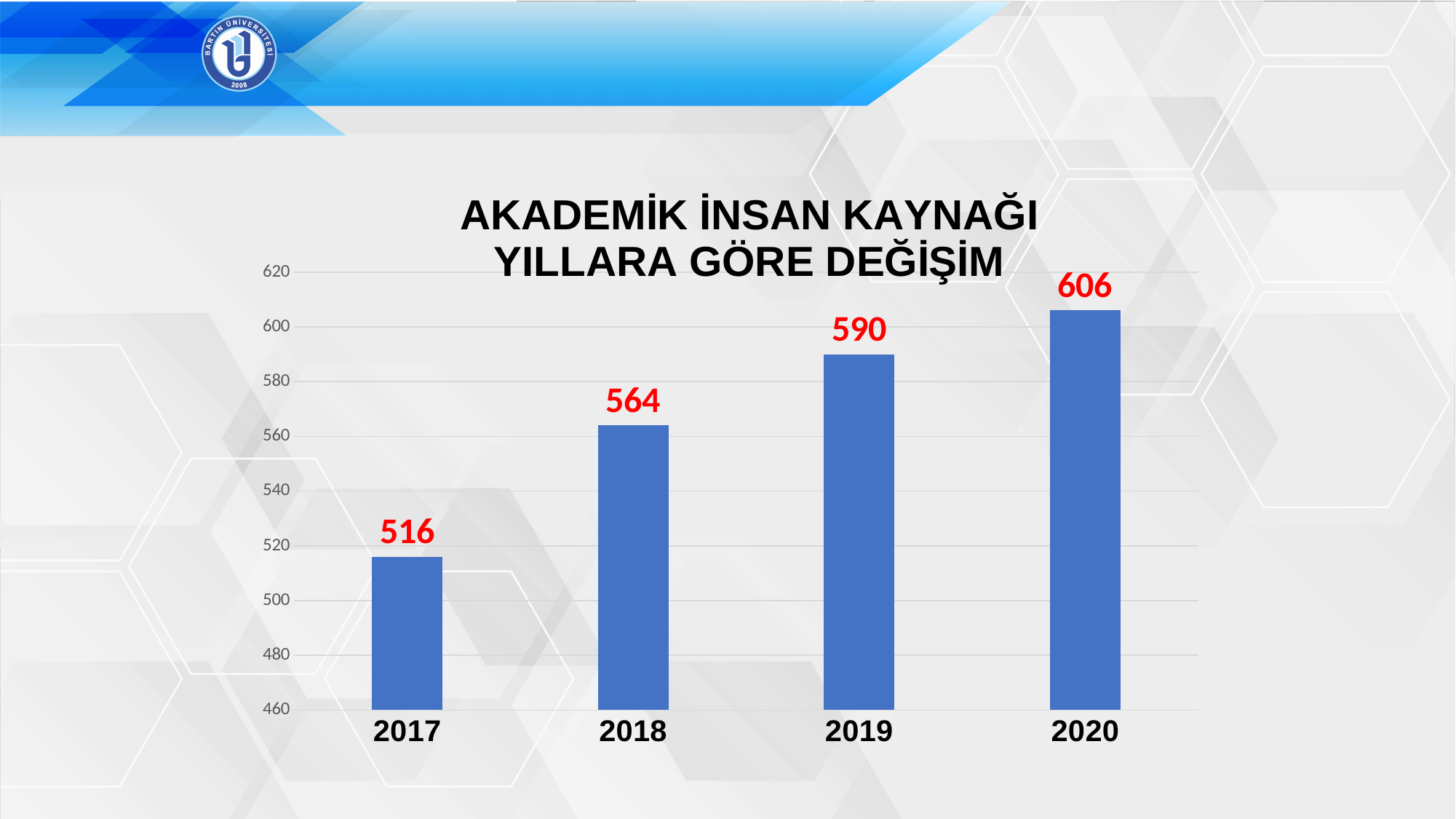
What is the difference between the values for 2019 and 2018? 26 What is the value for 2017? 516 What is the value for 2019? 590 What is the value for 2018? 564 What kind of chart is shown on the slide? bar chart Which is larger, the value for 2018 or the value for 2019? 2019 What is the difference between the values for 2020 and 2017? 90 Which year has the lowest value? 2017 What is the value for 2020? 606 Do the values rise or fall from 2017 to 2020? rise How many years are shown on the chart? 4 Which year has the highest value? 2020